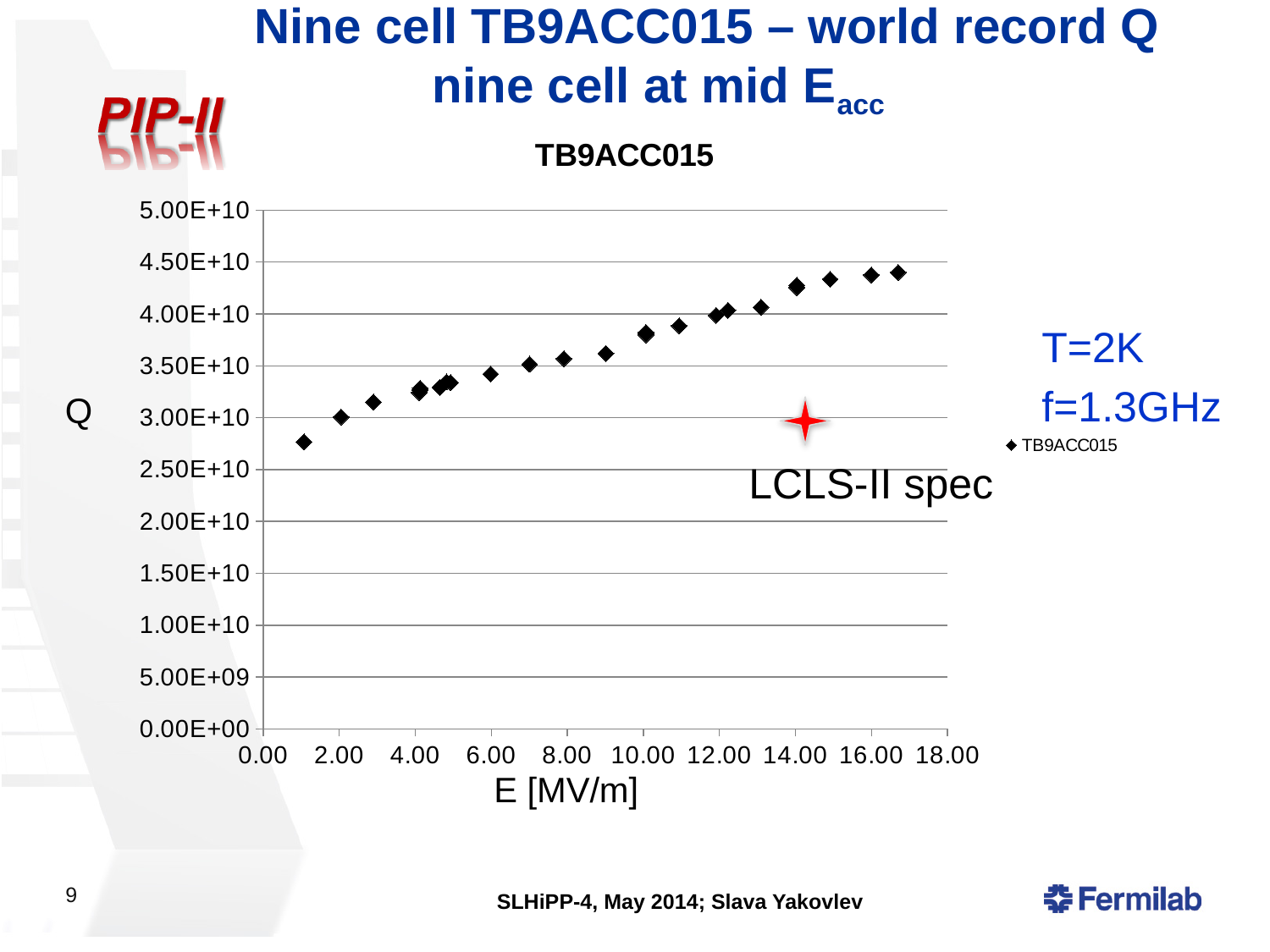
Is the Q value of the data point near E = 6 MV/m greater or less than 3.00E+10? greater How many series does the legend list? 1 Does Q rise or fall as E [MV/m] increases along the x axis? rise What does the red star marker on the chart indicate? LCLS-II spec What kind of chart is shown on the slide? scatter chart Is the Q value of the data point near E = 14 MV/m greater or less than 4.00E+10? greater Is the Q value of the rightmost data point (near E = 17 MV/m) greater or less than 4.00E+10? greater What is the title of the chart? TB9ACC015 Is the Q value of the data point near E = 2 MV/m larger or smaller than that of the point near E = 12 MV/m? smaller Which data point has the highest Q value: the one at the lowest E or the one at the highest E? the one at the highest E